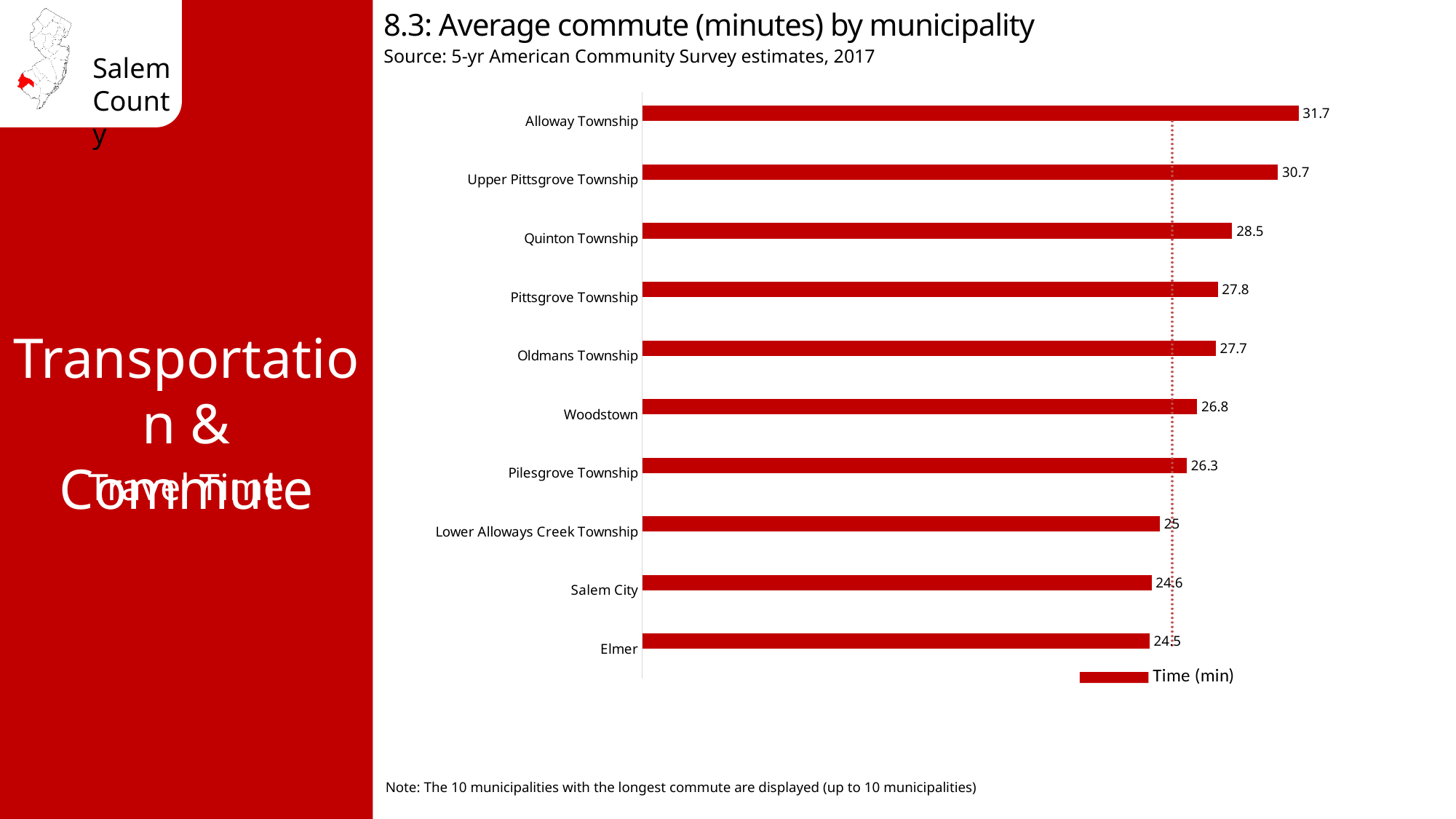
What is the legend entry for the series on the chart? Time (min) What is the average commute time for Alloway Township? 31.7 Which has a longer average commute, Pittsgrove Township or Pilesgrove Township? Pittsgrove Township What is the difference in average commute time between Alloway Township and Upper Pittsgrove Township? 1 How many municipalities are shown on the chart? 10 What kind of chart is shown on the slide? Bar chart What is the difference in average commute time between Quinton Township and Lower Alloways Creek Township? 3.5 Which municipality has the shortest average commute shown on the chart? Elmer What is the average commute time for Salem City? 24.6 How many series does the legend list? 1 What is the average commute time for Woodstown? 26.8 Which municipality has the longest average commute? Alloway Township